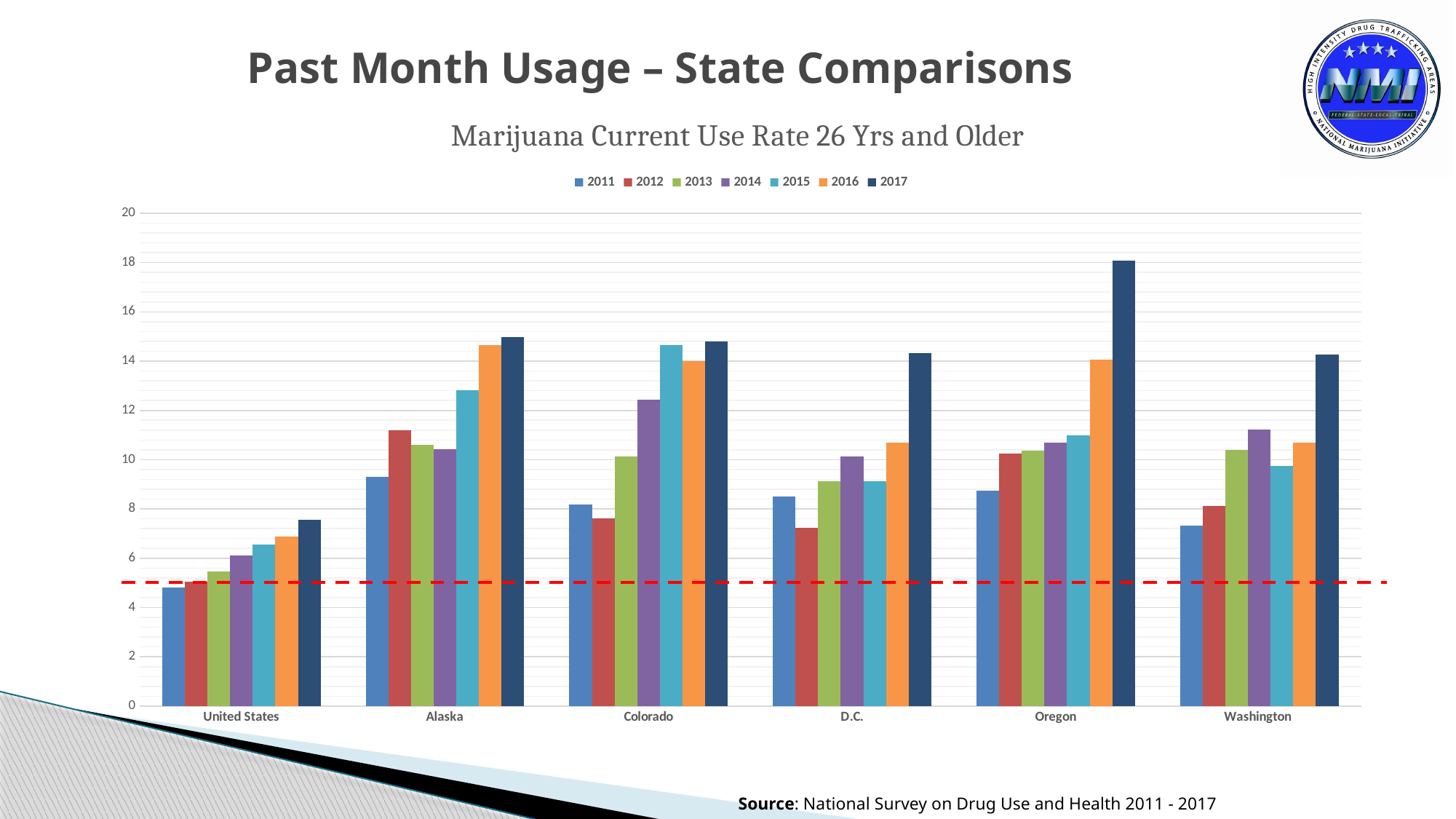
Which is larger for Washington, the 2014 value or the 2015 value? 2014 Do the United States values rise or fall from 2011 to 2017? rise How many states/regions are shown along the x axis? 6 Which state and year has the highest bar on the chart? Oregon, 2017 Is the 2017 value for United States greater or less than 8? less What kind of chart is shown on the slide? Bar chart Which category and year has the lowest bar on the chart? United States, 2011 What is the title of the chart? Marijuana Current Use Rate 26 Yrs and Older Is the 2016 value for Alaska greater or less than 14? greater Which is larger, the 2012 value for Alaska or the 2012 value for Colorado? Alaska Is the 2017 value for Oregon greater or less than 16? greater How many series does the legend list? 7